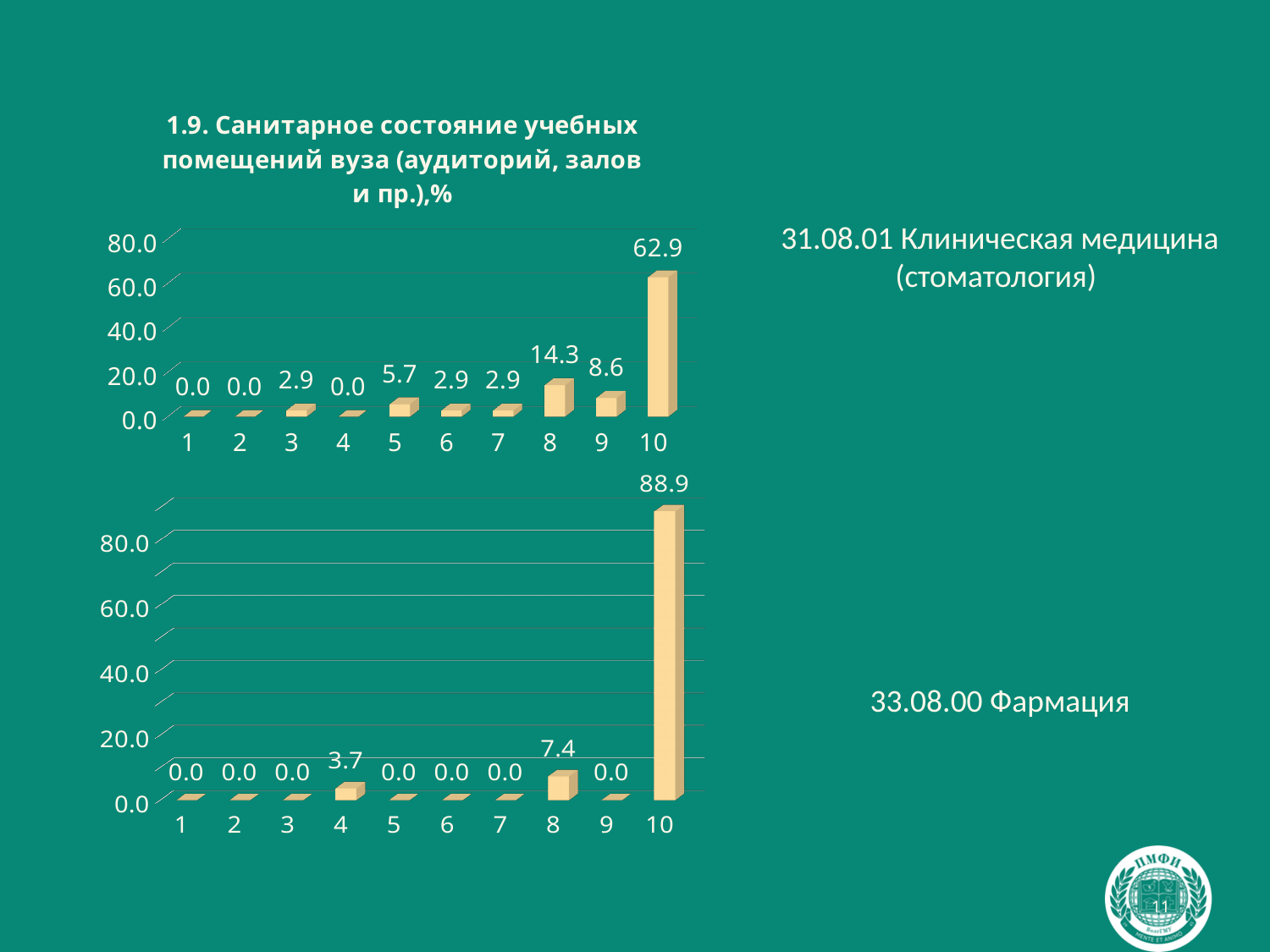
In the bottom chart (33.08.00 Фармация), what is the value for category 4? 3.7 In the top chart (31.08.01 Клиническая медицина (стоматология)), what is the value for category 10? 62.9 What kind of chart is the top chart (31.08.01 Клиническая медицина (стоматология))? bar chart In the bottom chart (33.08.00 Фармация), what is the difference between the values for category 8 and category 4? 3.7 In the top chart (31.08.01 Клиническая медицина (стоматология)), which is larger: the value for category 5 or the value for category 9? category 9 How many categories are shown on the x axis of the bottom chart (33.08.00 Фармация)? 10 In the top chart (31.08.01 Клиническая медицина (стоматология)), what is the difference between the values for category 10 and category 8? 48.6 In the top chart (31.08.01 Клиническая медицина (стоматология)), what is the value for category 9? 8.6 What is the title of the chart section shown on the slide? 1.9. Санитарное состояние учебных помещений вуза (аудиторий, залов и пр.),% In the top chart (31.08.01 Клиническая медицина (стоматология)), what is the value for category 8? 14.3 In the bottom chart (33.08.00 Фармация), what is the value for category 10? 88.9 In the bottom chart (33.08.00 Фармация), which category has the highest value? 10